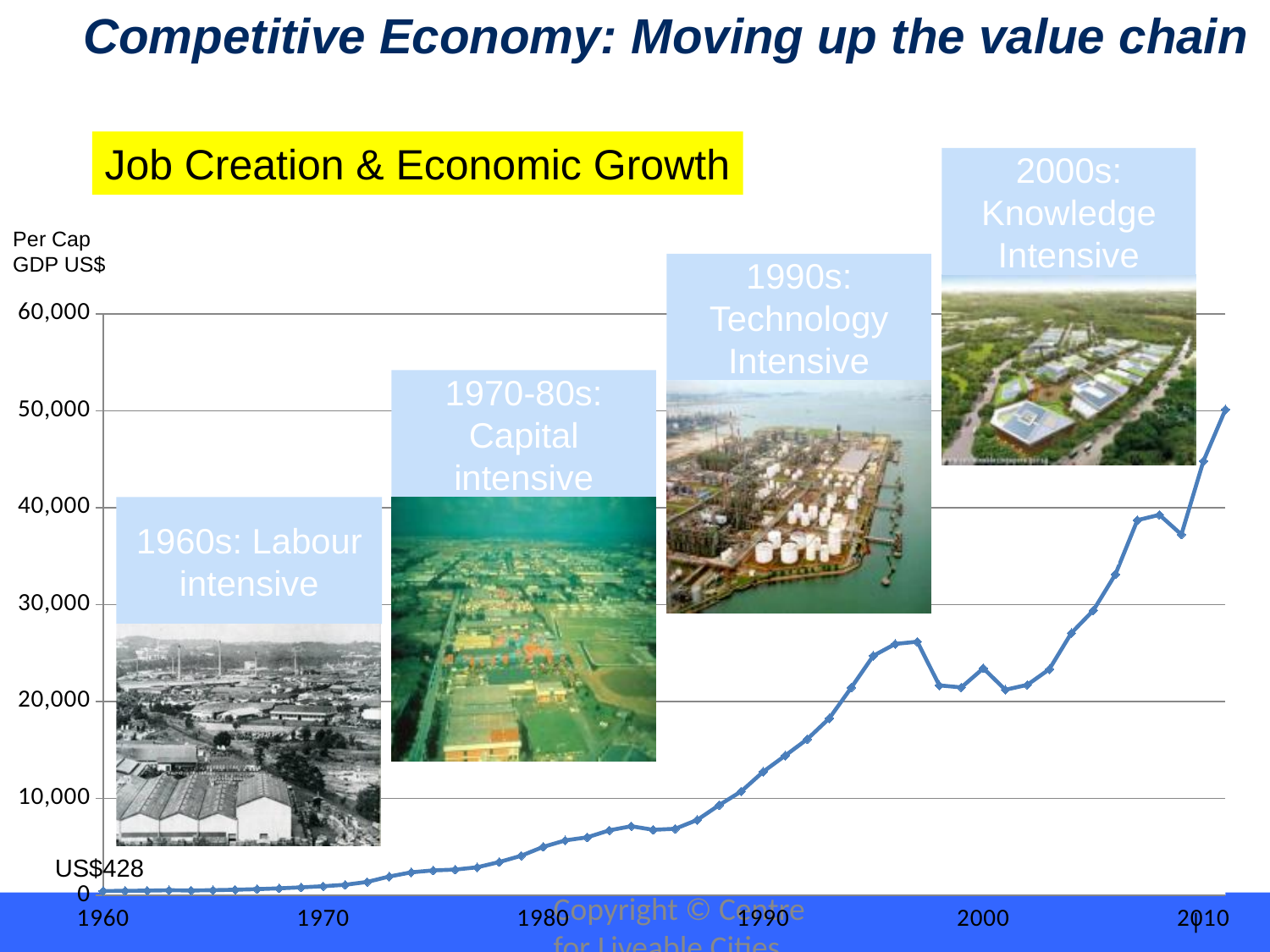
Do the per capita GDP values generally rise or fall from 1960 to 2010? rise Is the per capita GDP value for 2000 greater or less than 20,000? greater Which year has the larger per capita GDP, 1990 or 2000? 2000 What is the highlighted heading above the chart? Job Creation & Economic Growth What is the label on the vertical axis of the chart? Per Cap GDP US$ What is the per capita GDP value labelled for 1960? US$428 Which year on the x axis has the highest per capita GDP? 2010 Which year on the x axis has the lowest per capita GDP? 1960 Is the per capita GDP value for 1980 greater or less than 10,000? less Is the per capita GDP value for 1990 greater or less than 20,000? less What kind of chart is shown on the slide? line chart